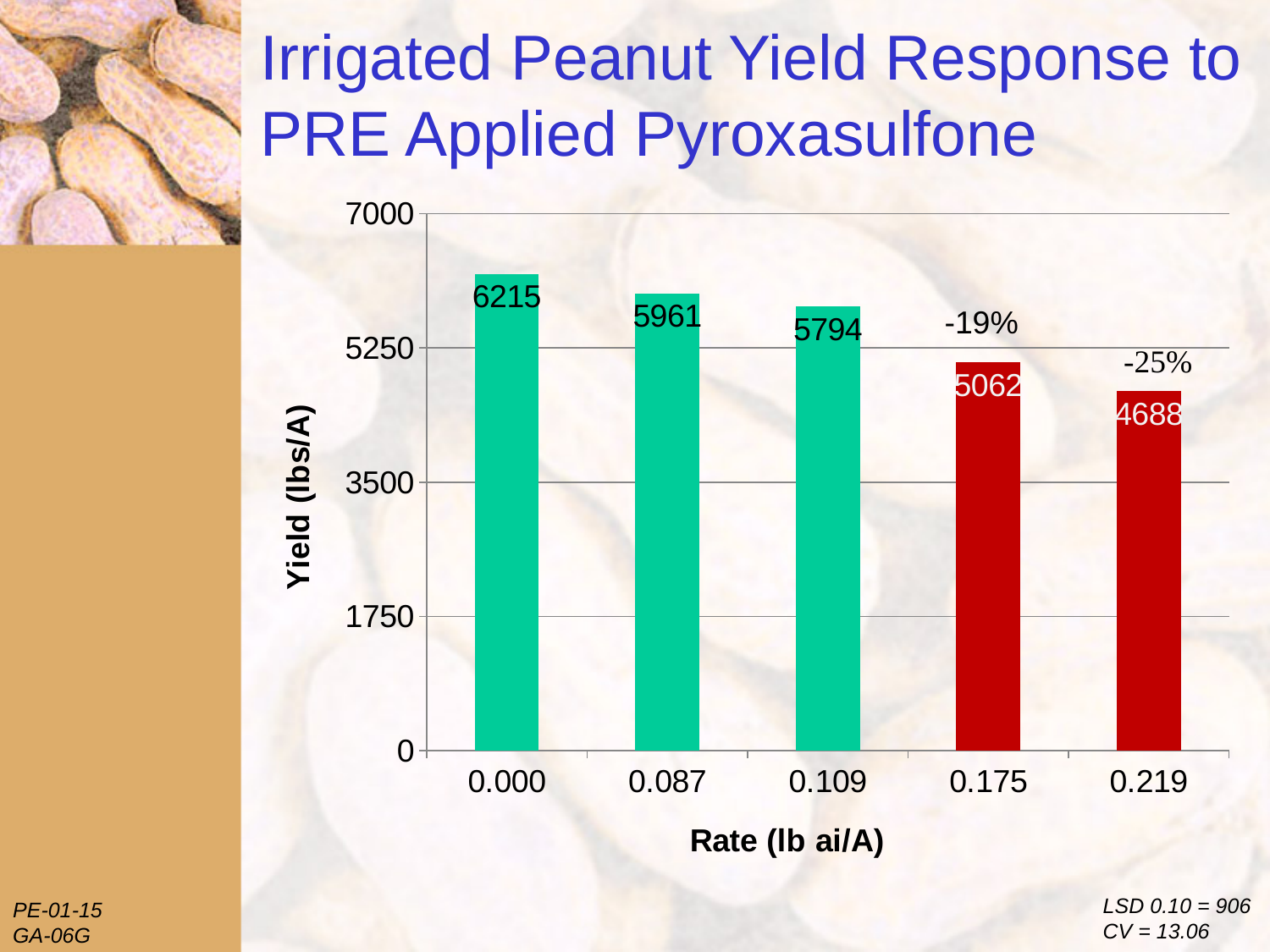
Which rate has the lowest yield? 0.219 How many rates are shown on the x axis? 5 What is the yield at a rate of 0.219 lb ai/A? 4688 What is the difference in yield between the 0.000 and 0.219 rates? 1527 Which rate has the highest yield? 0.000 What kind of chart is shown? bar chart What is the yield at a rate of 0.000 lb ai/A? 6215 What is the yield at a rate of 0.175 lb ai/A? 5062 Which has a higher yield, the 0.109 rate or the 0.175 rate? 0.109 What percentage change is labelled above the 0.175 rate bar? -19% What is the difference in yield between the 0.087 and 0.109 rates? 167 Does yield rise or fall as the rate increases along the x axis? fall